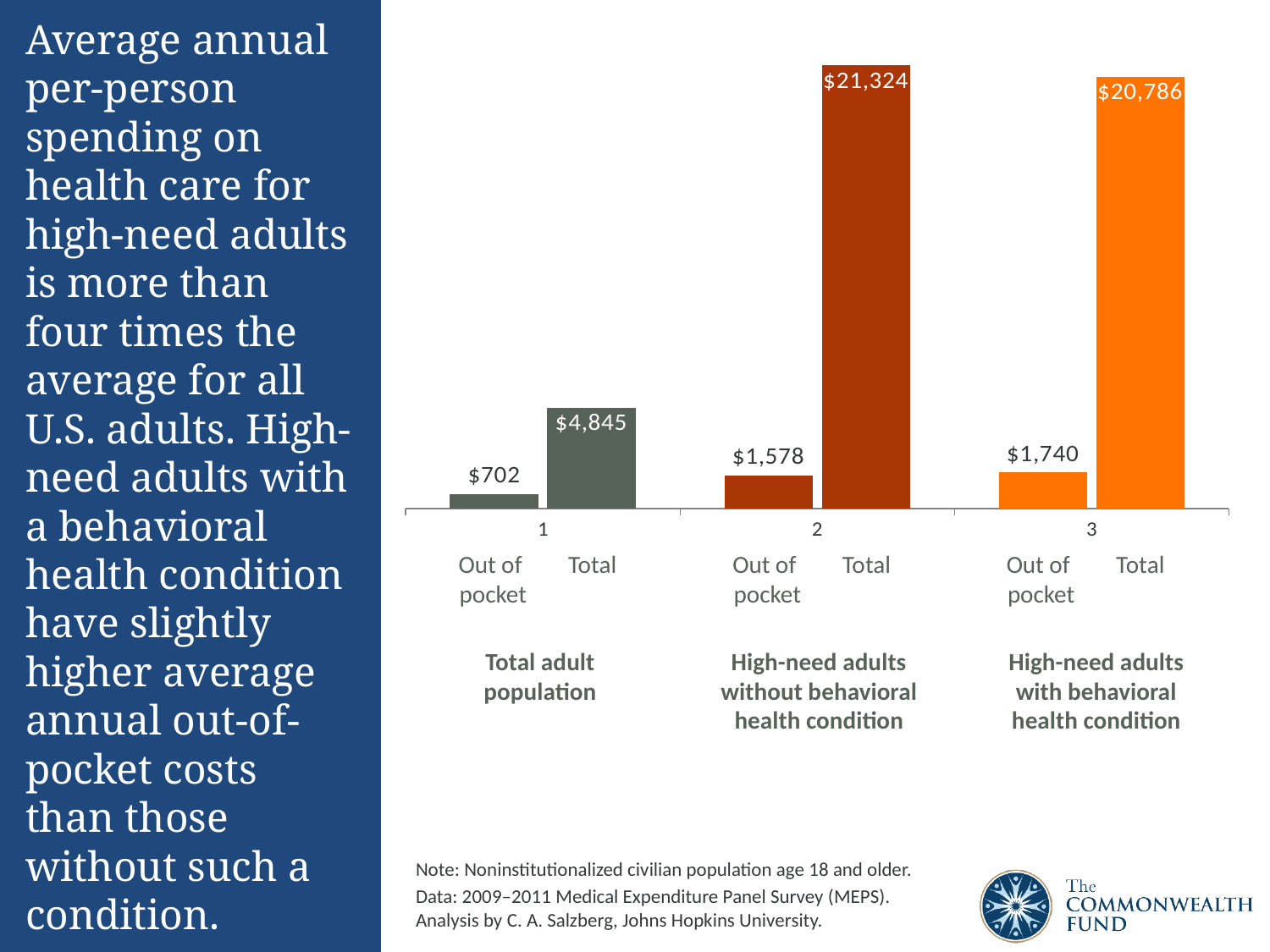
What is the total average annual per-person spending for high-need adults without a behavioral health condition? $21,324 What is the out-of-pocket spending for high-need adults with a behavioral health condition? $1,740 What is the total spending for the total adult population? $4,845 Which is larger: total spending for high-need adults without a behavioral health condition or total spending for high-need adults with a behavioral health condition? High-need adults without behavioral health condition What is the average annual out-of-pocket spending for the total adult population? $702 What is the difference in out-of-pocket spending between high-need adults with a behavioral health condition and those without? $162 Which group has the lowest out-of-pocket spending? Total adult population How many population groups are shown in the chart? 3 What type of chart is shown on the slide? Bar chart What is the difference between total spending and out-of-pocket spending for the total adult population? $4,143 Which group has the highest total spending? High-need adults without behavioral health condition What is the total spending for high-need adults with a behavioral health condition? $20,786